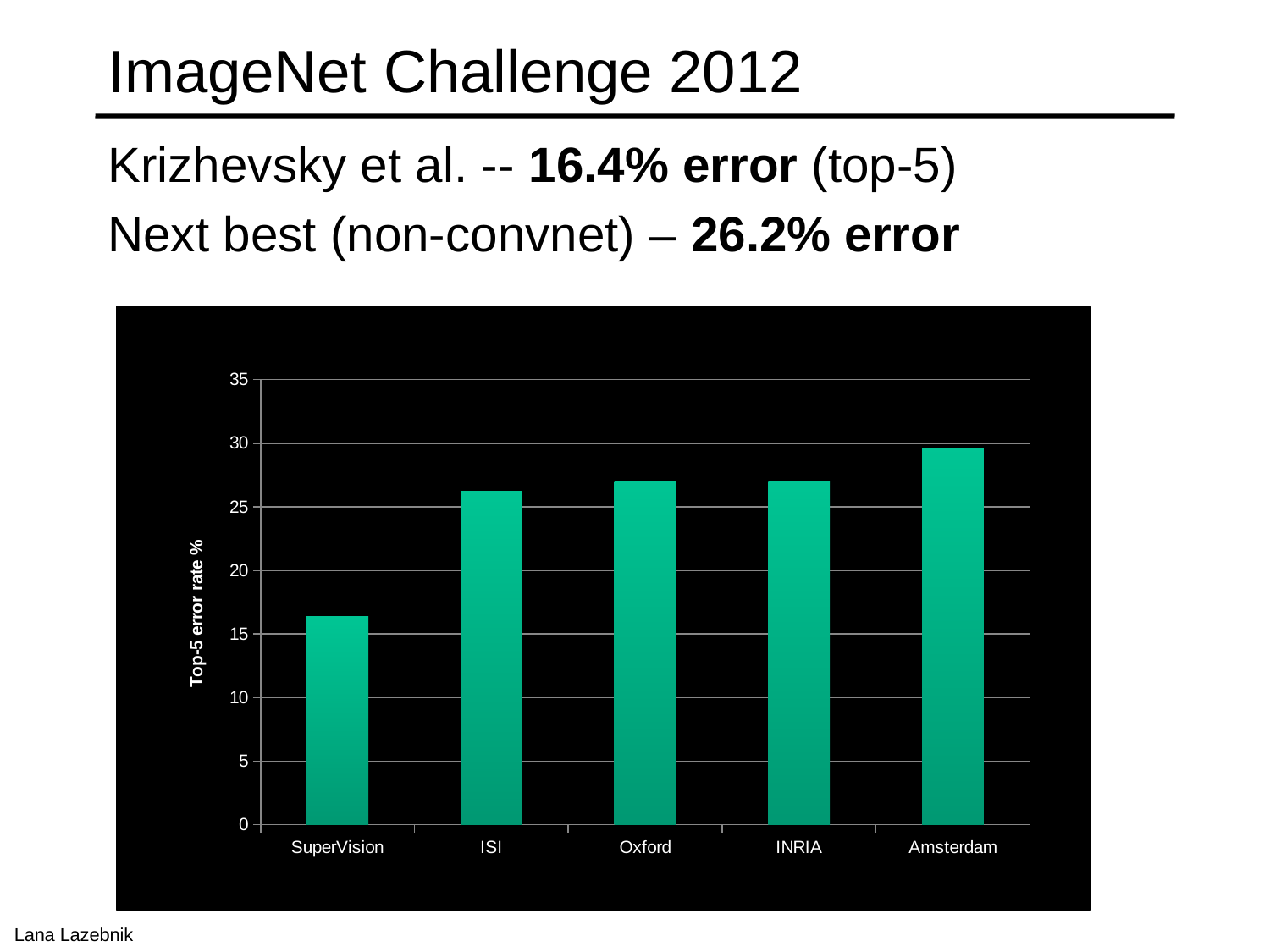
Which has a higher top-5 error rate, SuperVision or ISI? ISI What is the label on the vertical axis of the chart? Top-5 error rate % Which team has the highest top-5 error rate in the chart? Amsterdam Is the top-5 error rate for Oxford greater or less than 25? greater Which has a higher top-5 error rate, INRIA or Amsterdam? Amsterdam Is the top-5 error rate for ISI greater or less than 30? less Is the top-5 error rate for Amsterdam greater or less than 25? greater How many categories (teams) are shown on the x axis of the chart? 5 Do the bar values generally rise or fall from left to right across the x axis? rise Which team has the lowest top-5 error rate in the chart? SuperVision What kind of chart is shown on the slide? bar chart